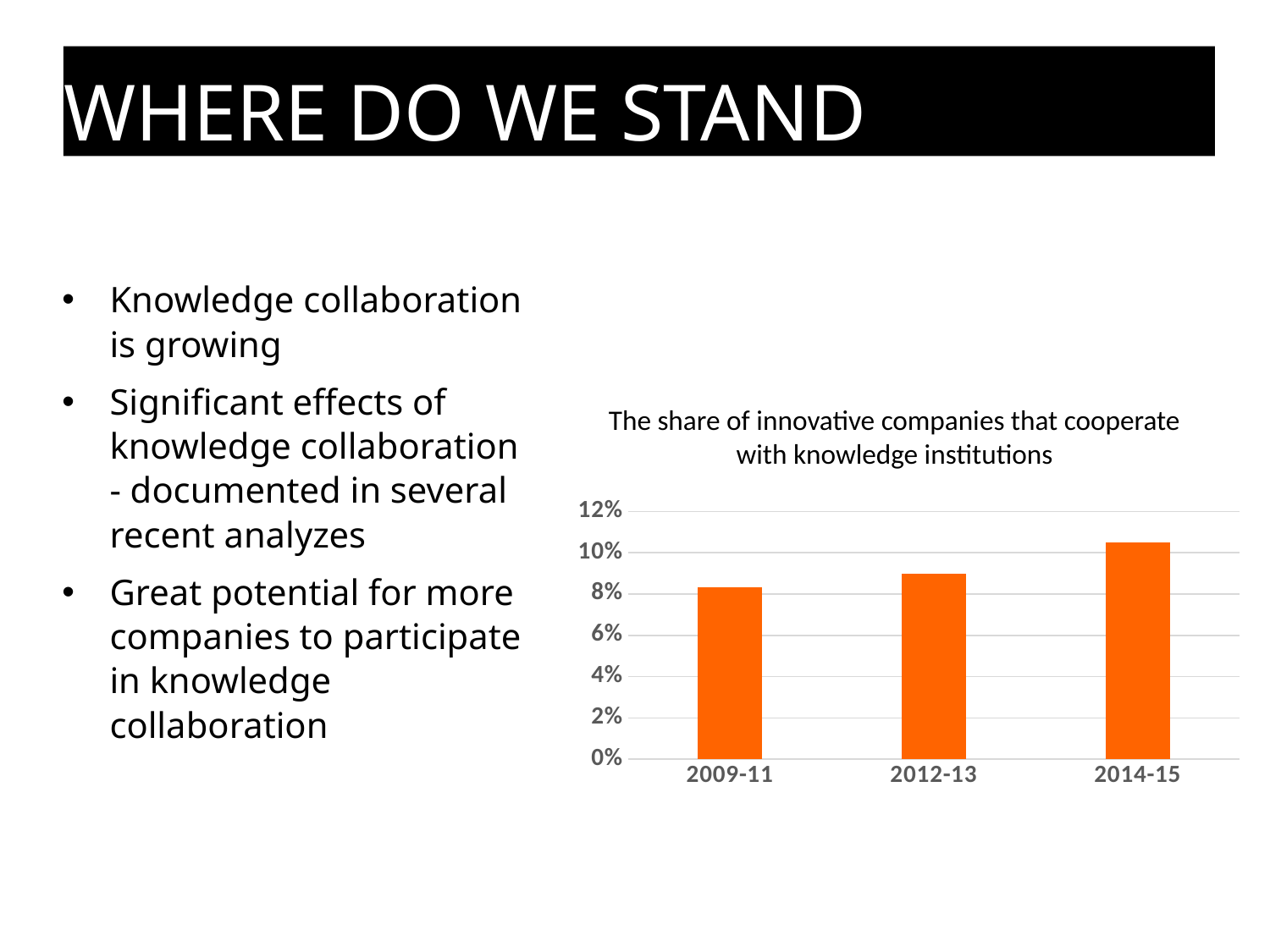
Do the values rise or fall from 2009-11 to 2014-15? rise What type of chart is shown on the slide? bar chart Which period has the lowest share of innovative companies cooperating with knowledge institutions? 2009-11 Is the value for 2012-13 greater or less than 8%? greater Is the value for 2009-11 greater or less than 6%? greater Is the value for 2014-15 greater or less than 10%? greater What is the title of the chart? The share of innovative companies that cooperate with knowledge institutions Which period has the highest share of innovative companies cooperating with knowledge institutions? 2014-15 Which is larger, the value for 2012-13 or the value for 2014-15? 2014-15 What colour are the bars in the chart? orange How many categories are shown on the x axis of the chart? 3